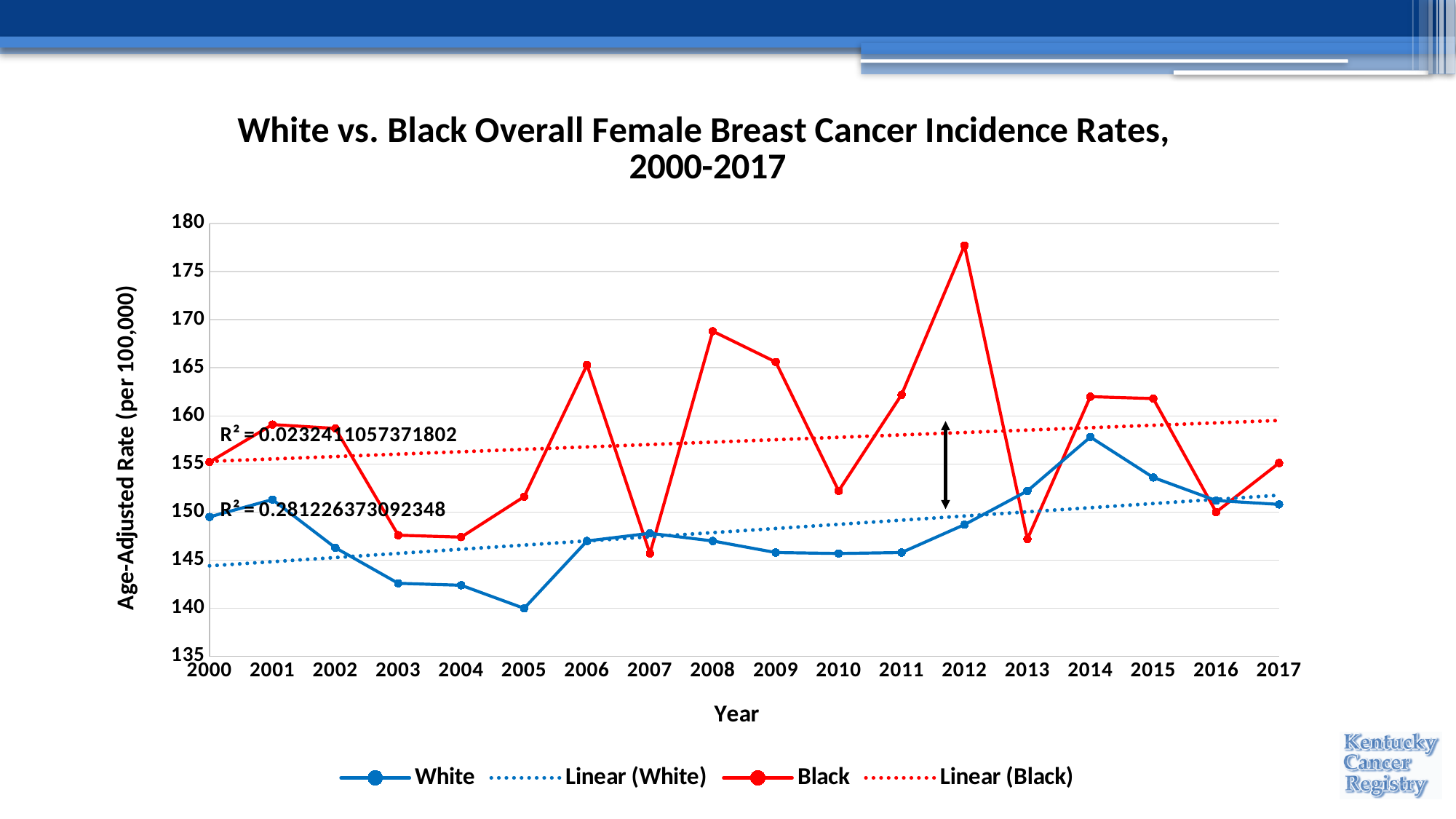
Which series has the larger value in 2012, White or Black? Black How many years are plotted along the x axis? 18 How many entries does the legend list? 4 Is the Black rate in 2008 greater or less than 165? greater In which year is the White incidence rate highest? 2014 In which year is the White incidence rate lowest? 2005 Which series has the larger value in 2013, White or Black? White Is the White rate in 2005 greater or less than 145? less What is the label of the y axis? Age-Adjusted Rate (per 100,000) Is the Black rate in 2012 greater or less than 175? greater What kind of chart is shown on the slide? Line chart In which year is the Black incidence rate highest? 2012